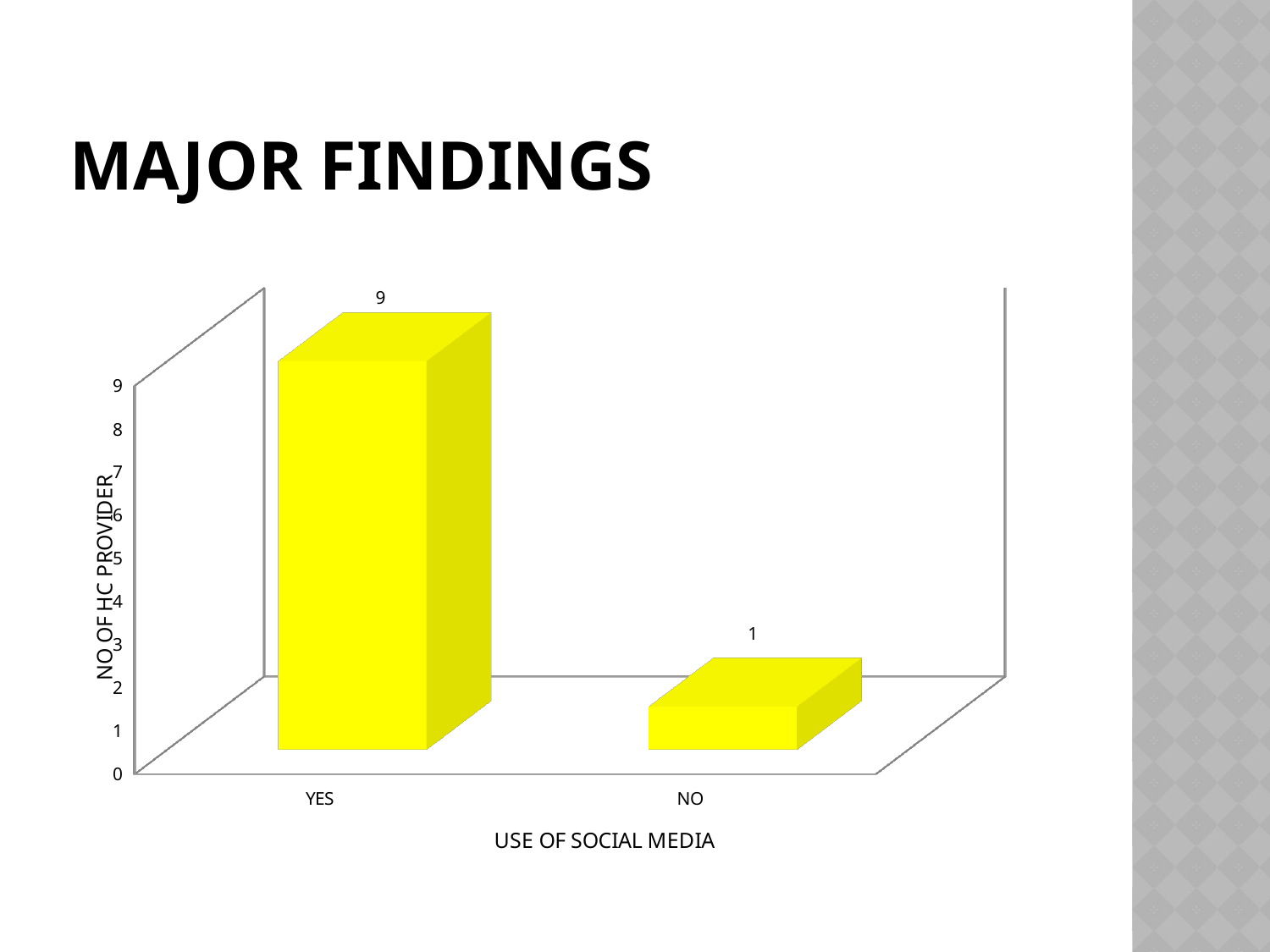
Which category has the highest value? YES How many categories are shown on the x axis? 2 Is the value for YES greater or less than 5? greater What is the label of the y axis? NO OF HC PROVIDER What is the total of the values for YES and NO? 10 What is the value for NO? 1 What is the difference between the values for YES and NO? 8 Which category has the lowest value? NO Which is larger, the value for YES or the value for NO? YES What is the label of the x axis? USE OF SOCIAL MEDIA What is the value for YES? 9 What kind of chart is shown on the slide? bar chart